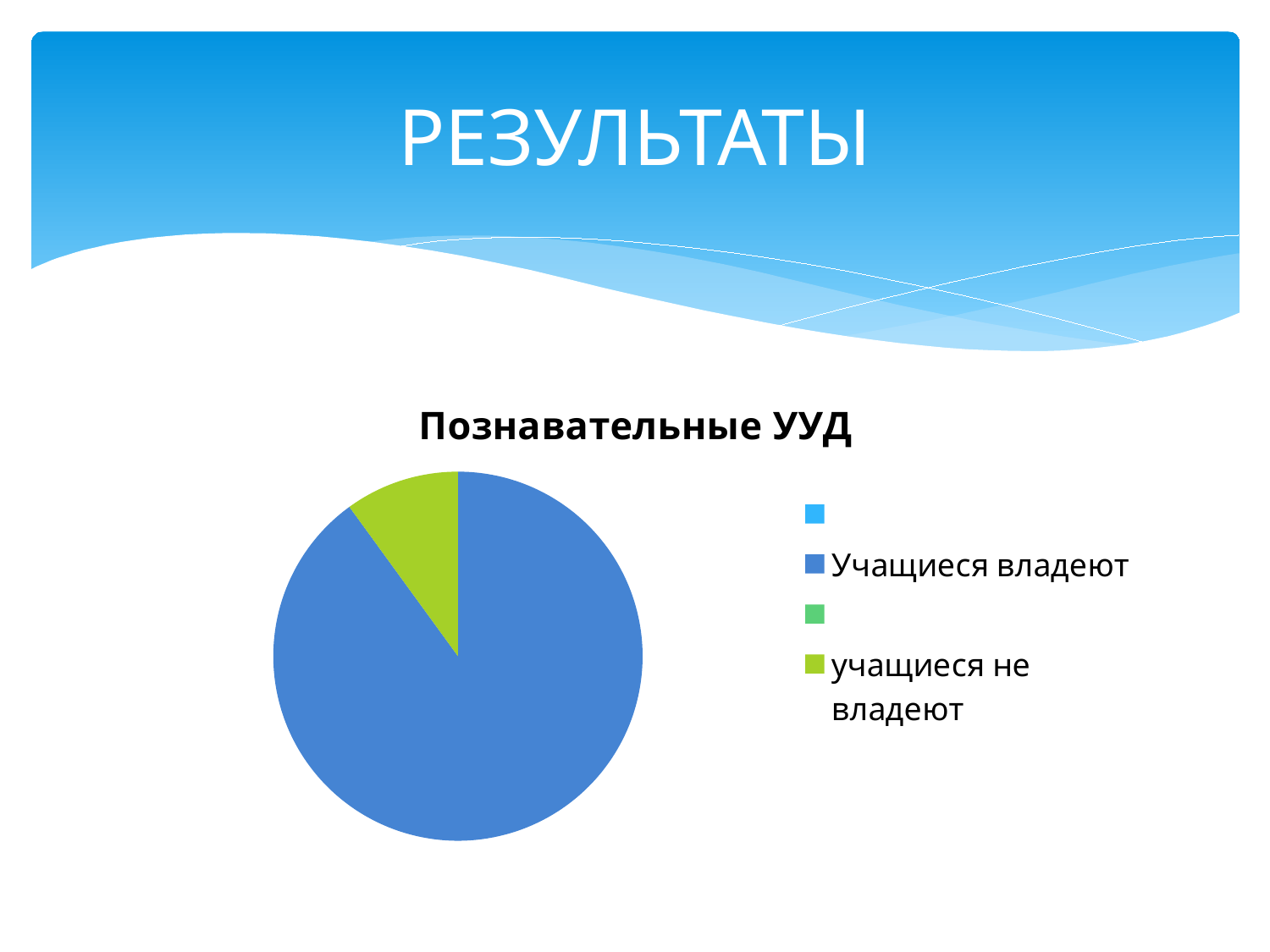
What is the title of the chart? Познавательные УУД What kind of chart is shown on the slide? pie chart Which category has the smallest slice of the pie? учащиеся не владеют How many slices are visible in the pie chart? 2 How many legend entries have a readable text label? 2 Which category has the largest slice of the pie? Учащиеся владеют Which is larger: the slice for 'Учащиеся владеют' or the slice for 'учащиеся не владеют'? Учащиеся владеют Does the slice for 'Учащиеся владеют' take up more or less than half of the pie? more What colour is the slice for 'учащиеся не владеют'? green